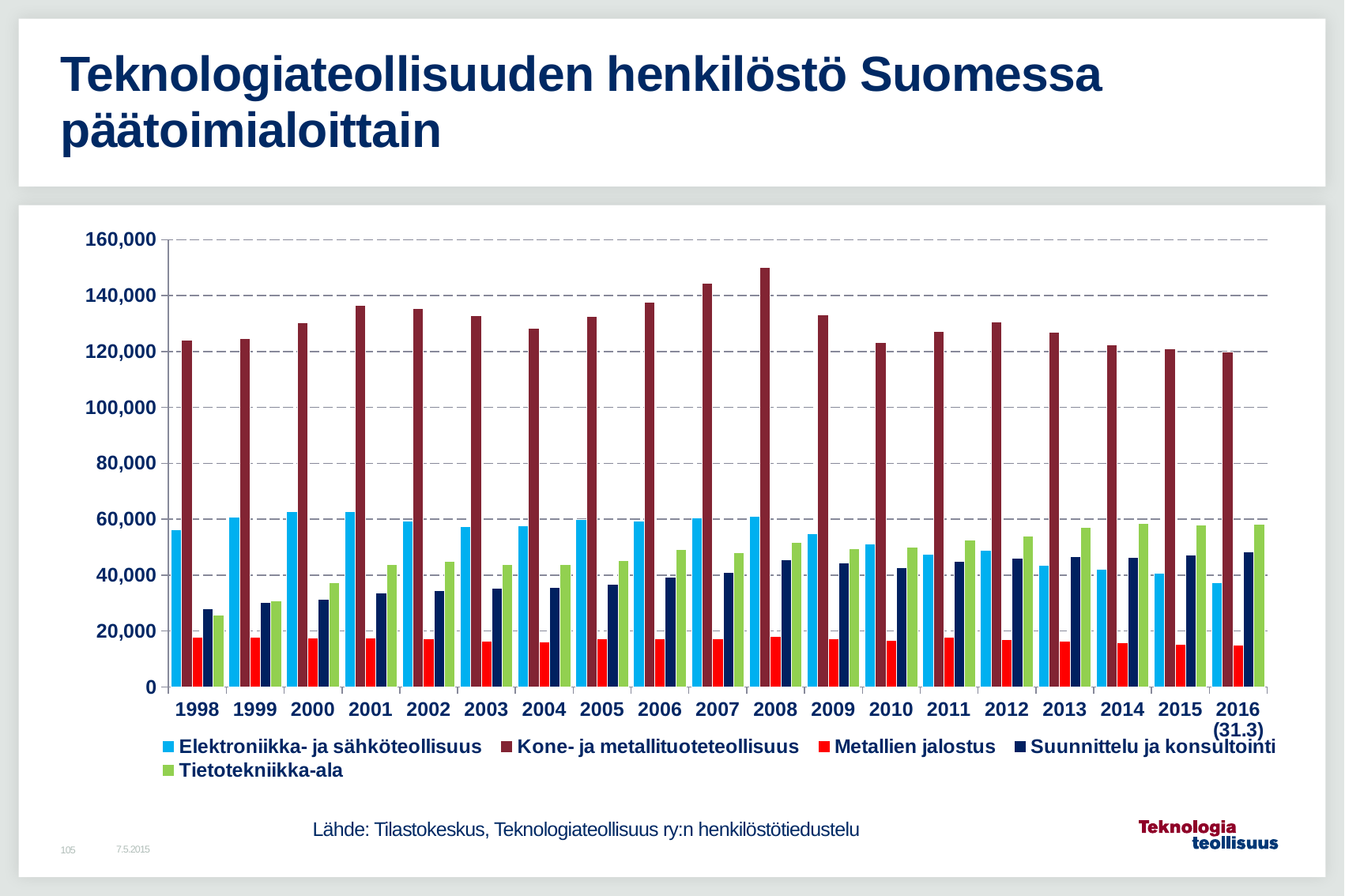
Which is larger: Elektroniikka- ja sähköteollisuus in 2000 or in 2016 (31.3)? 2000 In which year is the value for Kone- ja metallituoteteollisuus highest? 2008 How many series does the legend list? 5 Does the value for Tietotekniikka-ala generally rise or fall from 1998 to 2016 (31.3)? rise Is the value for Tietotekniikka-ala in 2014 greater or less than 40,000? greater Is the value for Kone- ja metallituoteteollisuus in 2008 greater or less than 140,000? greater What kind of chart is shown on the slide? Bar chart Which series has the highest value in every year shown? Kone- ja metallituoteteollisuus Is the value for Elektroniikka- ja sähköteollisuus in 2016 (31.3) greater or less than 40,000? less Which series has the lowest value in every year shown? Metallien jalostus How many years are shown on the x axis? 19 Which is larger in 2016 (31.3): Tietotekniikka-ala or Elektroniikka- ja sähköteollisuus? Tietotekniikka-ala